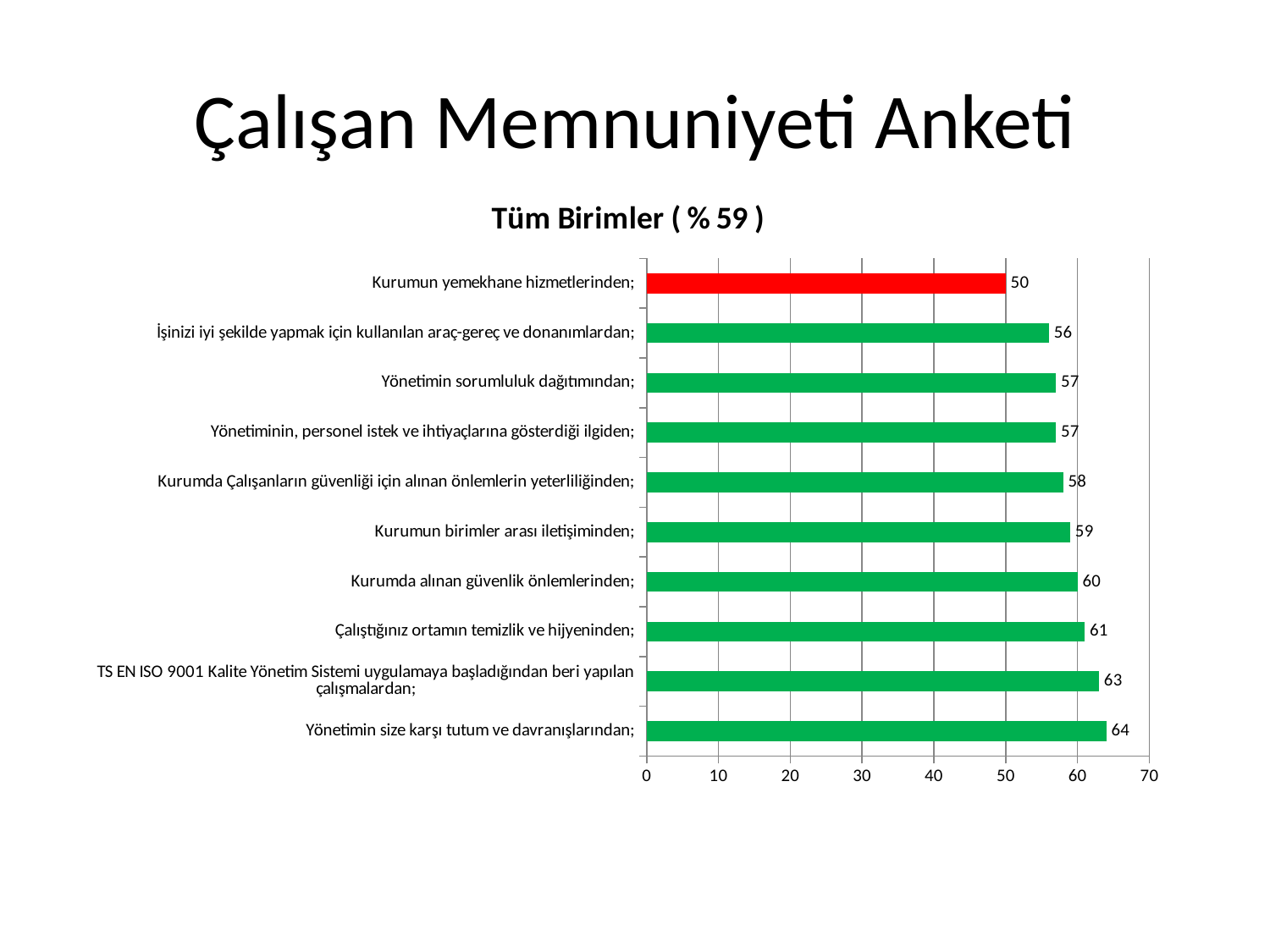
Which is larger: the value for "Kurumda alınan güvenlik önlemlerinden;" or the value for "İşinizi iyi şekilde yapmak için kullanılan araç-gereç ve donanımlardan;"? Kurumda alınan güvenlik önlemlerinden; What is the value for "Çalıştığınız ortamın temizlik ve hijyeninden;"? 61 Which category has the highest value? Yönetimin size karşı tutum ve davranışlarından; What is the title of the chart? Tüm Birimler ( % 59 ) Which category has the lowest value? Kurumun yemekhane hizmetlerinden; How many categories are shown in the chart? 10 What is the difference between the values for "Yönetimin size karşı tutum ve davranışlarından;" and "Kurumun yemekhane hizmetlerinden;"? 14 What is the value for "Yönetimin size karşı tutum ve davranışlarından;"? 64 What is the value for "Kurumun yemekhane hizmetlerinden;"? 50 What is the value for "TS EN ISO 9001 Kalite Yönetim Sistemi uygulamaya başladığından beri yapılan çalışmalardan;"? 63 Which bar is coloured red rather than green? Kurumun yemekhane hizmetlerinden; What kind of chart is shown on the slide? Bar chart